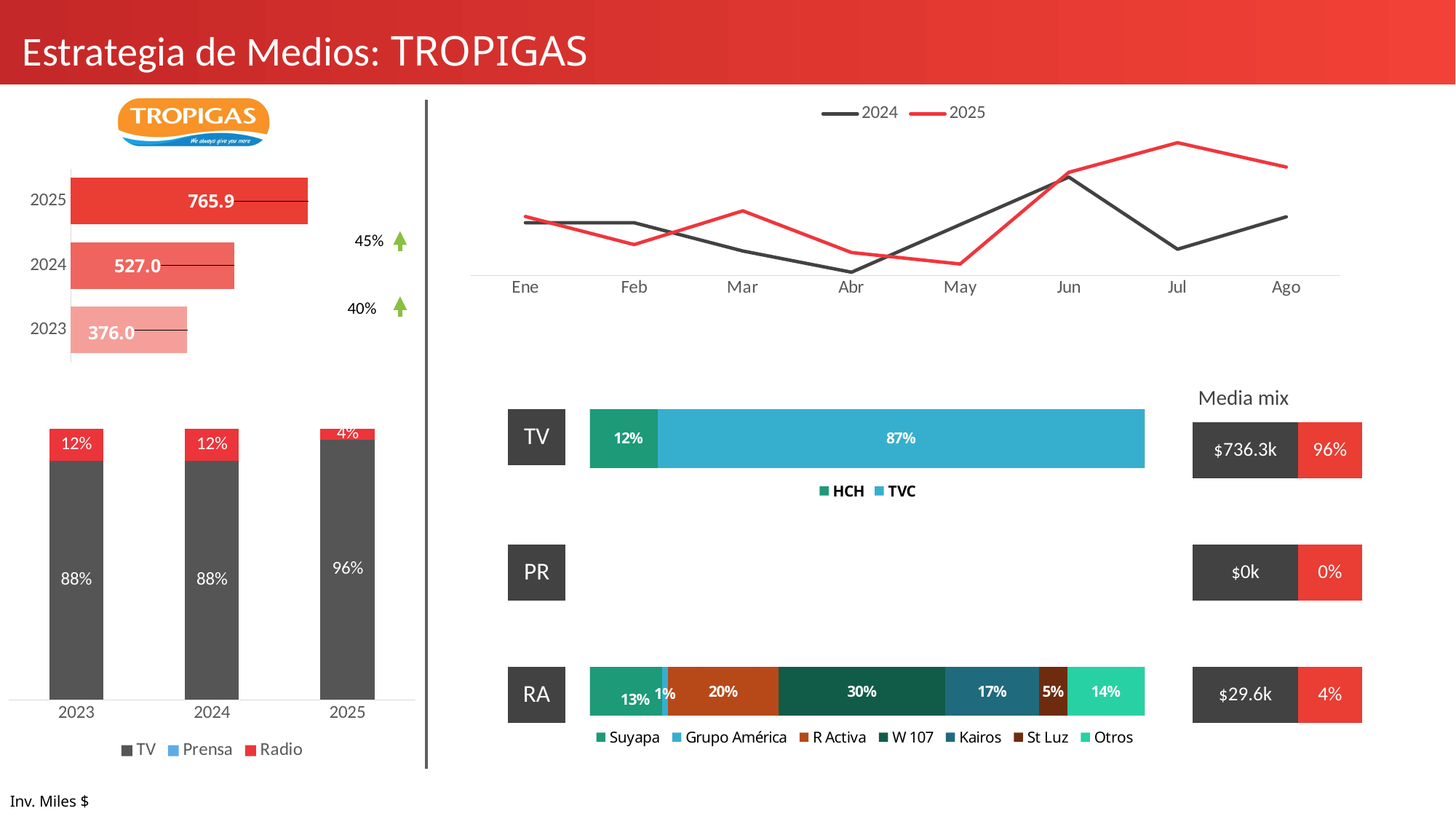
In the horizontal bar chart of yearly investment at the top left, what is the value for 2023? 376.0 In the TV stacked bar on the right, what is the share for TVC? 87% In the line chart at the top right, how many series does the legend list? 2 In the stacked bar chart at the bottom left, what is the TV share for 2025? 96% In the horizontal bar chart of yearly investment at the top left, which year has the lowest value? 2023 In the RA stacked bar on the right, which station has the largest share? W 107 In the line chart at the top right, which series is higher in Jul, 2024 or 2025? 2025 In the horizontal bar chart of yearly investment at the top left, what is the value for 2025? 765.9 In the Media mix table on the right, what is the amount shown for RA? $29.6k In the stacked bar chart at the bottom left, what is the Radio share for 2024? 12% In the line chart at the top right, how many months are shown on the x axis? 8 In the horizontal bar chart of yearly investment at the top left, what is the difference between the 2025 and 2024 values? 238.9